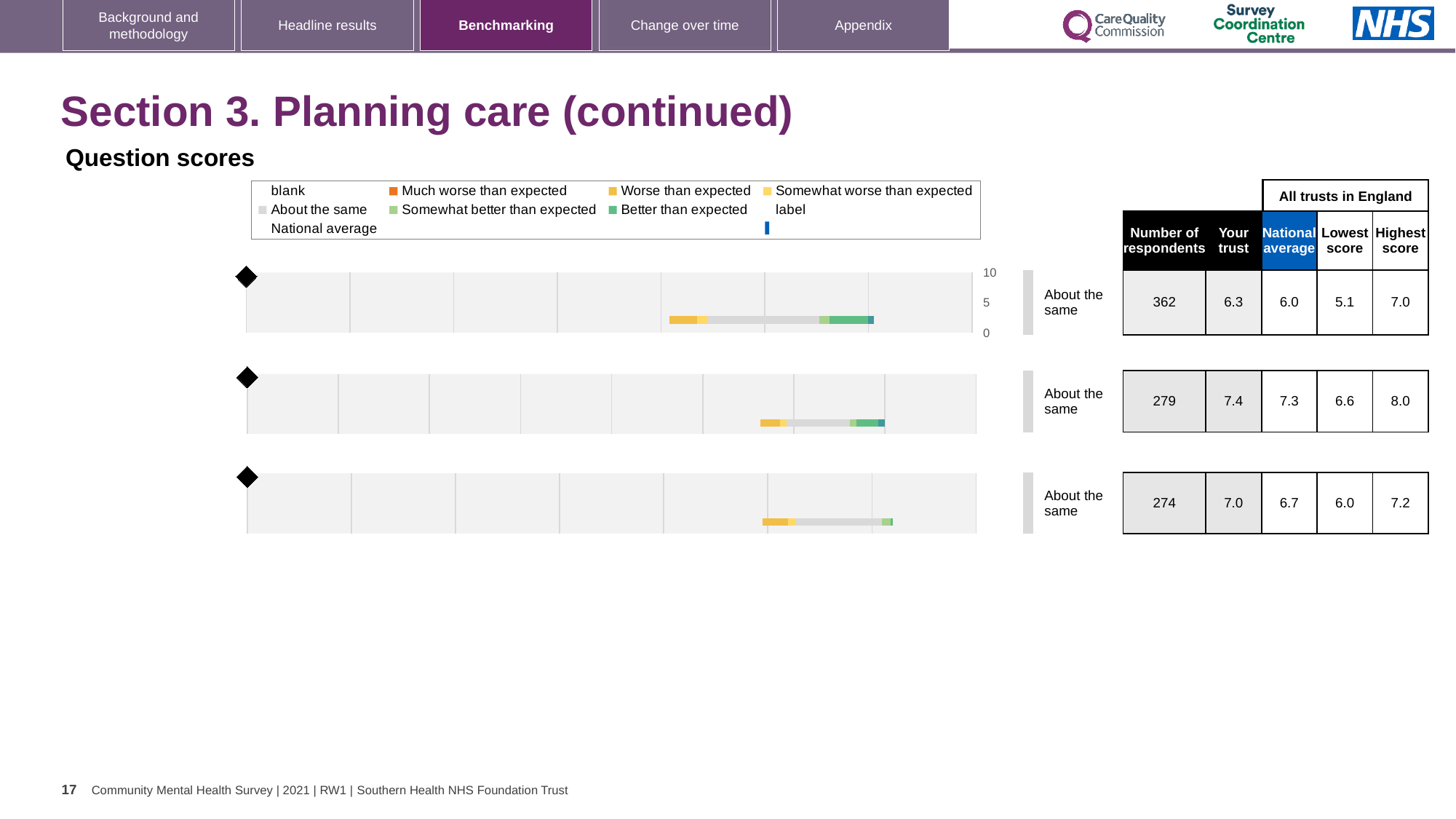
What kind of chart is used for the three question-score charts on the slide? bar chart For the bottom chart, what is the highest score among all trusts in England? 7.2 For the top chart, what is the difference between the highest score and the lowest score? 1.9 Which of the three charts has the highest 'Your trust' score? the middle chart For the middle chart, what is the national average score? 7.3 For the top chart, what is the 'Your trust' score? 6.3 How many question-score charts are shown on the slide? 3 For the top chart, what is the number of respondents? 362 What is the maximum value shown on the vertical axis of the top chart? 10 For the middle chart, which is larger: the 'Your trust' score or the national average? Your trust What benchmark category is the bottom chart's trust score placed in? About the same In the legend, which category is shown in orange? Much worse than expected